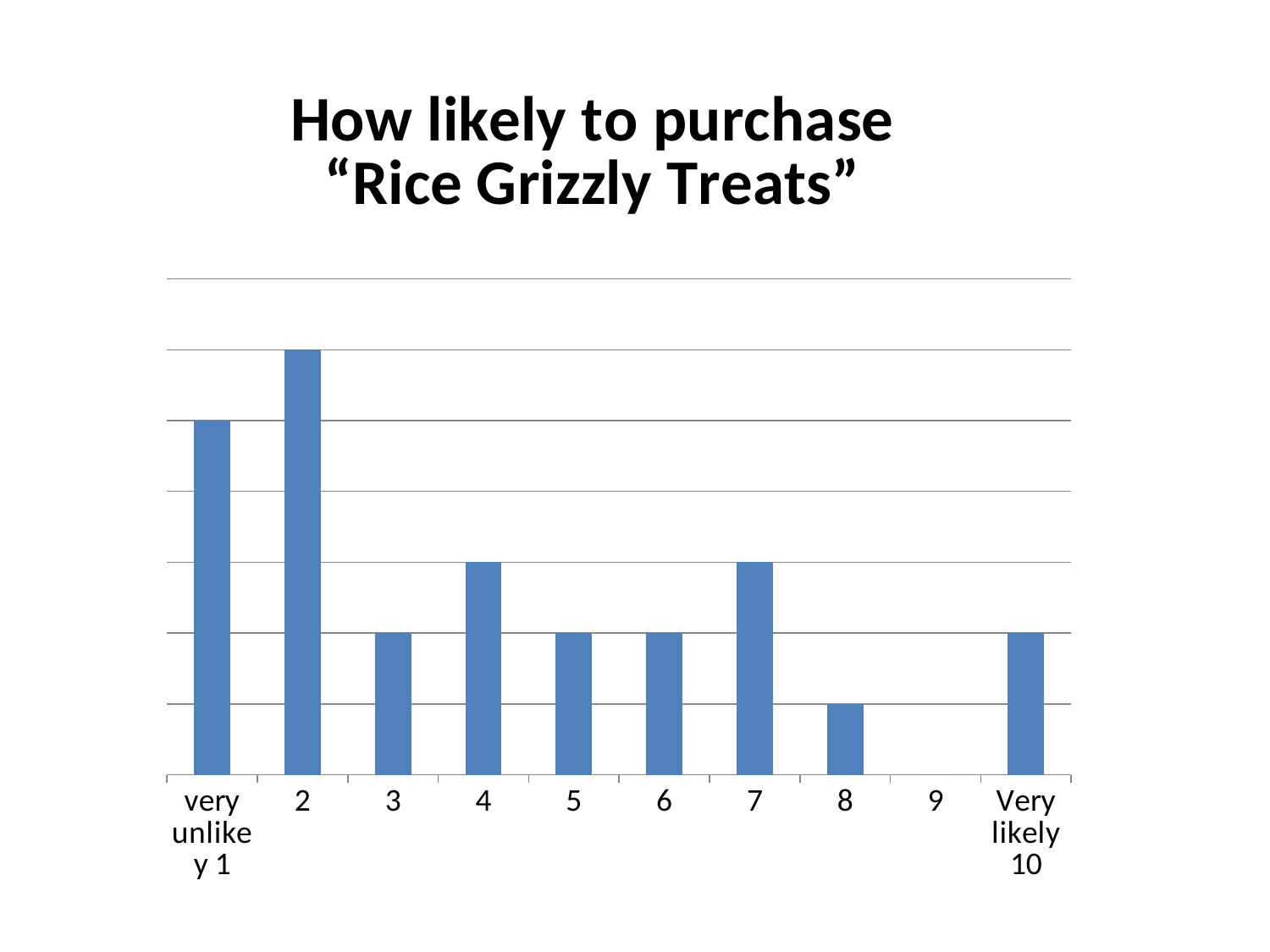
What kind of chart is shown on the slide? bar chart How many categories are shown on the x axis? 10 Which is larger, the value for 3 or the value for 4? 4 Which is larger, the value for "very unlikely 1" or the value for 7? very unlikely 1 Which is larger, the value for 7 or the value for 8? 7 Which category has the tallest bar? 2 Which category has the lowest value (no visible bar)? 9 Do the values rise or fall from category 2 to category 3? fall What colour are the bars in the chart? blue What is the title of the chart? How likely to purchase "Rice Grizzly Treats"